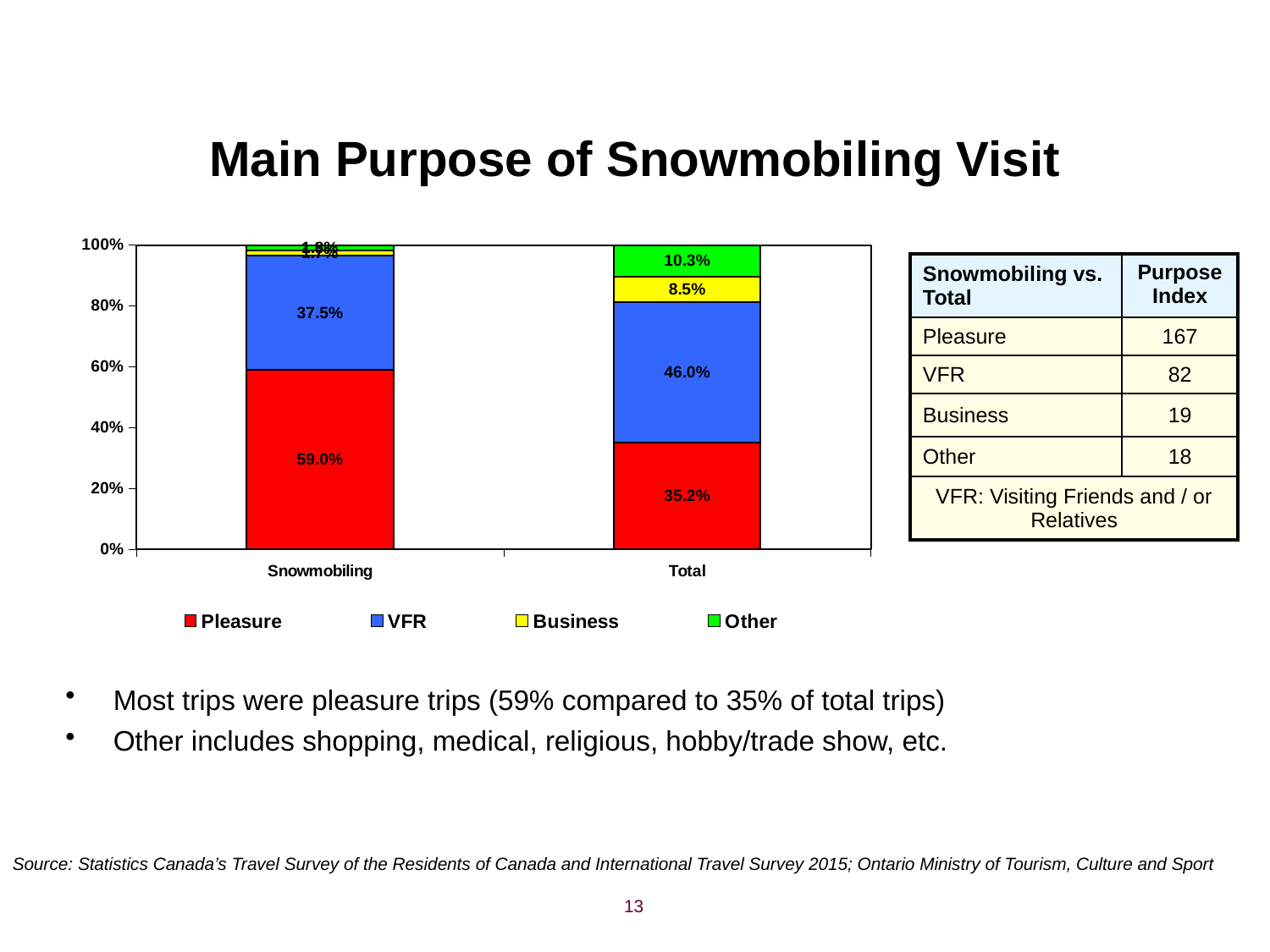
What is the Business share for the Total bar? 8.5% What is the VFR share for the Total bar? 46.0% What is the Pleasure share for the Total bar? 35.2% Which purpose makes up the largest segment of the Snowmobiling bar? Pleasure How many series does the legend list? 4 What kind of chart is shown on the slide? Stacked bar chart What is the Other share for the Total bar? 10.3% How many percentage points higher is the Pleasure share for Snowmobiling than for Total? 23.8 percentage points What percentage of Snowmobiling trips were for Pleasure? 59.0% Which purpose makes up the largest segment of the Total bar? VFR Which bar has the larger VFR share, Snowmobiling or Total? Total What is the VFR share for the Snowmobiling bar? 37.5%